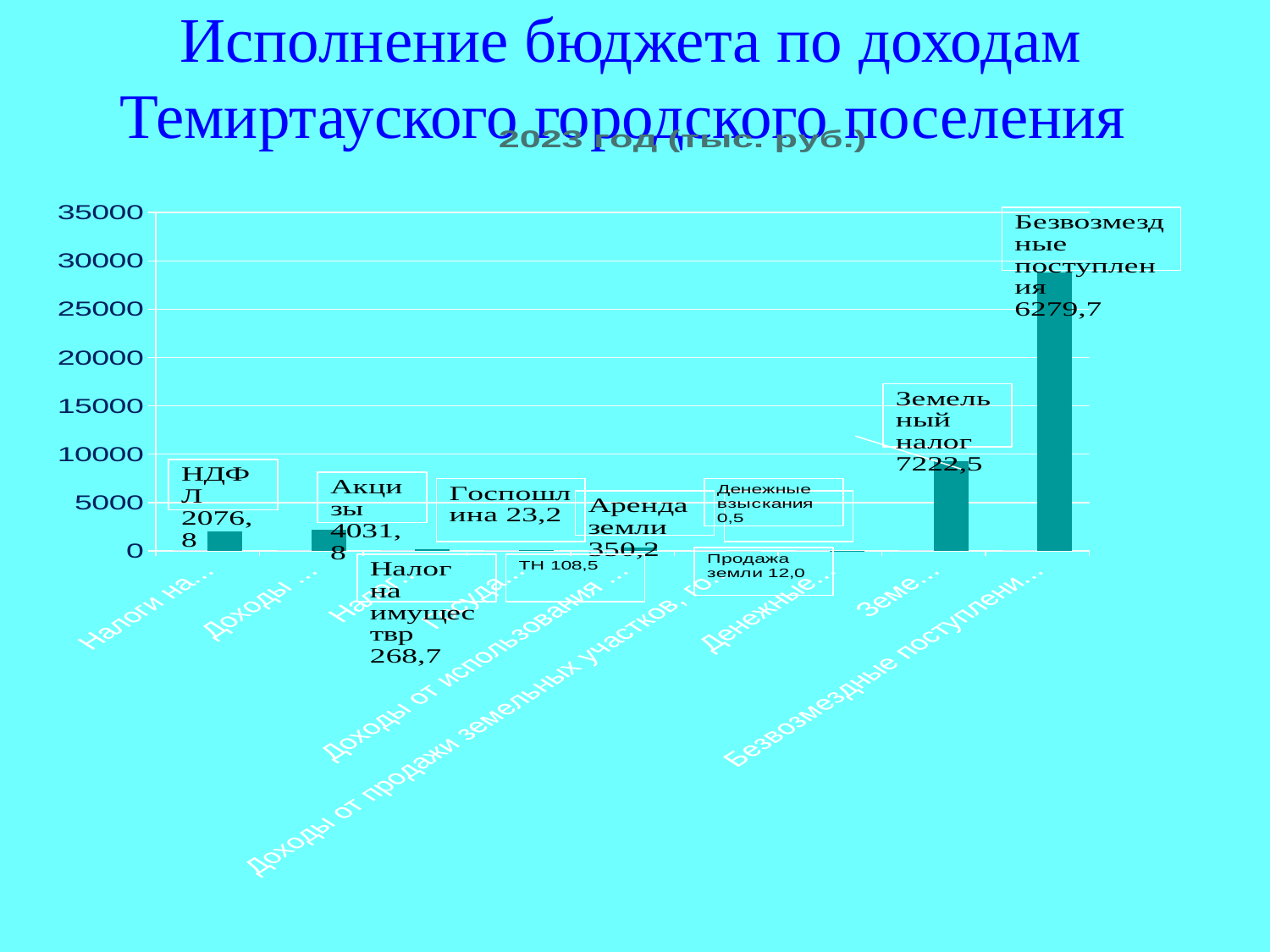
What is the value for Госпошлина? 23,2 Which is larger, Акцизы or НДФЛ? Акцизы What is the value for Налог на имущество? 268,7 What is the value for Денежные взыскания? 0,5 What is the value for Земельный налог? 7222,5 What is the difference between Земельный налог and Акцизы? 3190,7 What is the value for Продажа земли? 12,0 What kind of chart is shown on the slide? bar chart What is the value for НДФЛ? 2076,8 What is the value for Акцизы? 4031,8 Is the bar for Безвозмездные поступления greater or less than 25000? greater What is the value for Аренда земли? 350,2